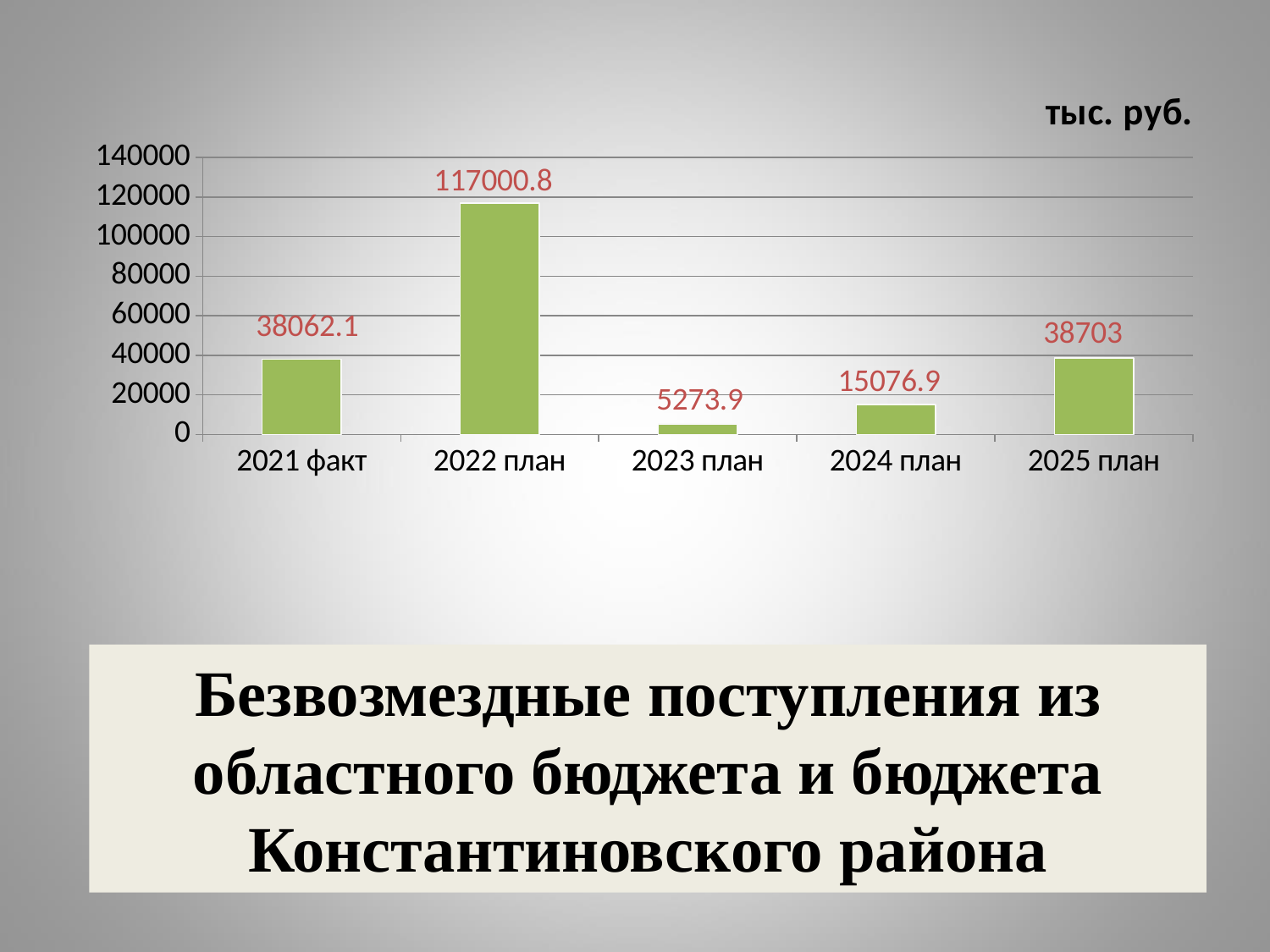
Which category has the lowest value? 2023 план Which is larger, the value for 2022 план or the value for 2024 план? 2022 план What unit is indicated for the values in the chart? тыс. руб. What is the value for 2021 факт? 38062.1 What is the value for 2022 план? 117000.8 What is the difference between the values for 2022 план and 2021 факт? 78938.7 What is the value for 2025 план? 38703 Which category has the highest value? 2022 план What is the value for 2023 план? 5273.9 What is the value for 2024 план? 15076.9 What is the difference between the values for 2024 план and 2023 план? 9803 How many categories are shown on the x axis? 5